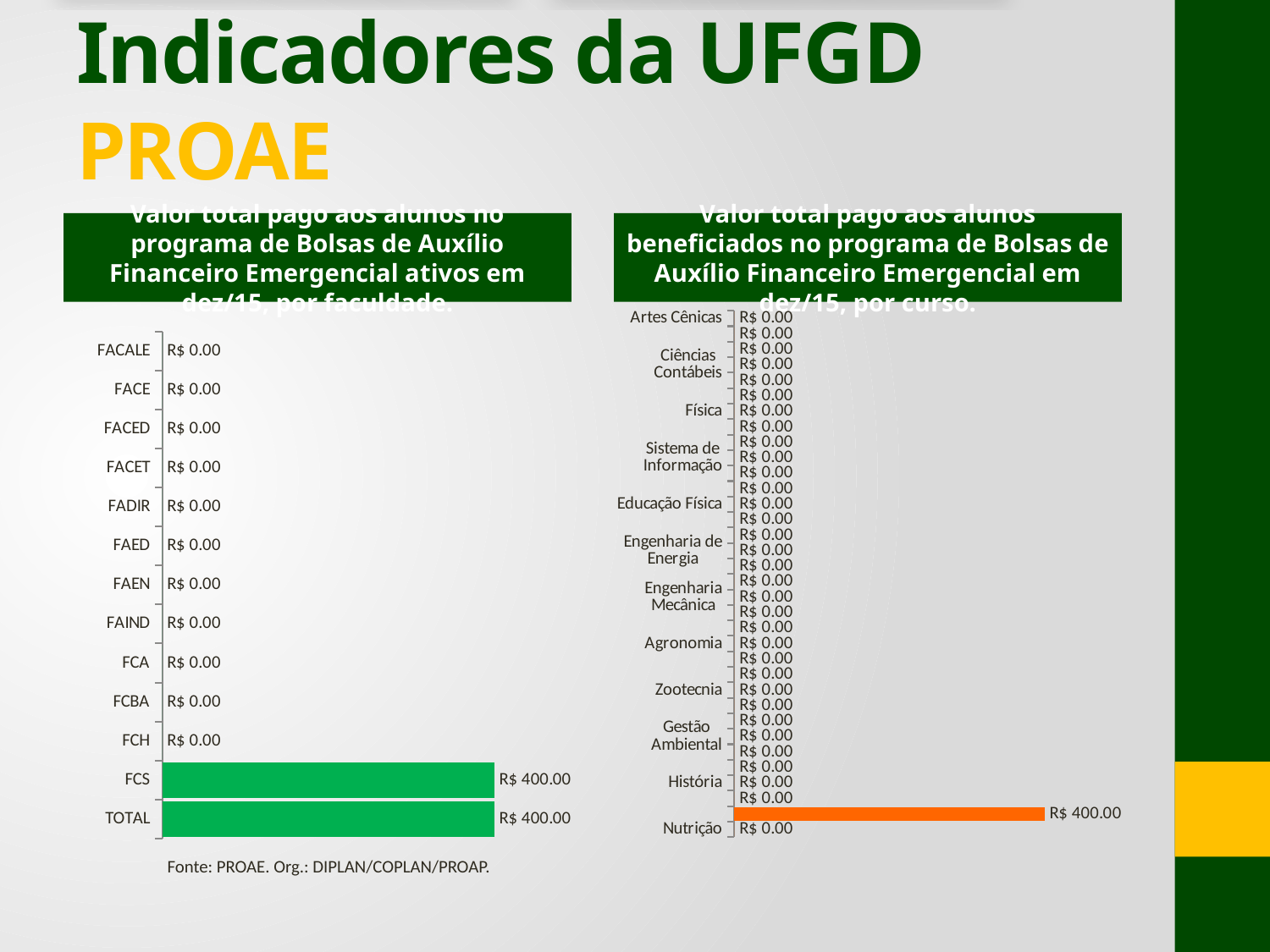
In the right chart (por curso), what is the value for Artes Cênicas? R$ 0.00 What kind of chart is the left chart (por faculdade)? Bar chart In the left chart (por faculdade), how many categories are shown, including TOTAL? 13 In the right chart (por curso), what is the value for Nutrição? R$ 0.00 In the left chart (por faculdade), which faculty (excluding TOTAL) has the highest value? FCS In the left chart (por faculdade), what is the value for FACALE? R$ 0.00 In the left chart (por faculdade), what is the value for TOTAL? R$ 400.00 In the left chart (por faculdade), what is the value for FCH? R$ 0.00 In the left chart (por faculdade), which is larger, the value for FCS or the value for FAEN? FCS In the left chart (por faculdade), what is the value for FCS? R$ 400.00 What is the highest value shown in the right chart (por curso)? R$ 400.00 In the left chart (por faculdade), what is the difference between the values for FCS and FADIR? R$ 400.00